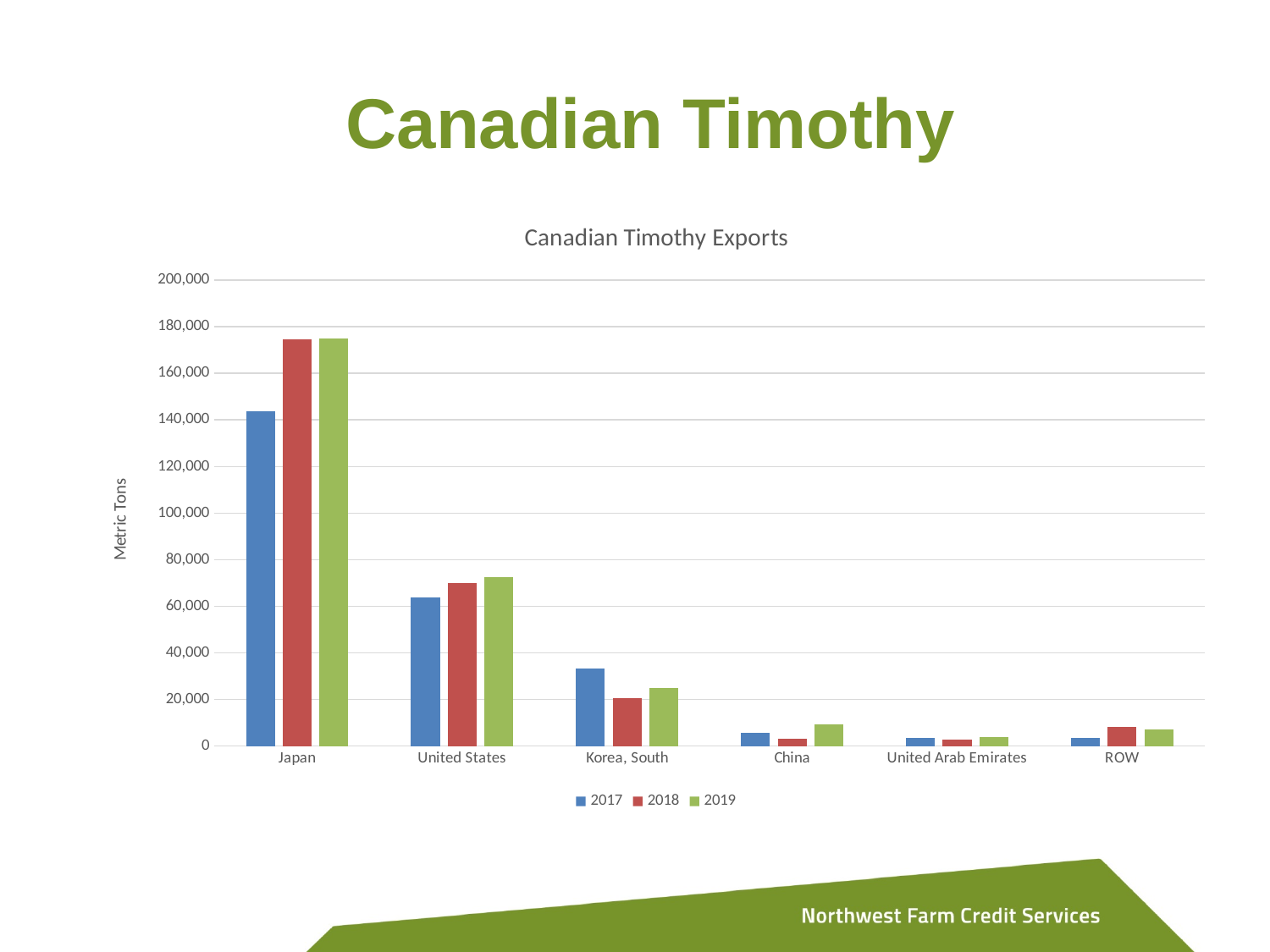
How many export destination categories are shown on the x axis? 6 Is the value for Korea, South in 2017 greater or less than 20,000? greater Is the value for United States in 2019 greater or less than 80,000? less How many series does the legend list? 3 Which is larger for Korea, South: the 2017 value or the 2018 value? 2017 What type of chart is shown on the slide? Bar chart Which is larger for China: the 2018 value or the 2019 value? 2019 What is the title of the chart? Canadian Timothy Exports Is the value for Japan in 2017 greater or less than 140,000? greater What unit is shown on the y axis label? Metric Tons Which destination has the highest Canadian timothy exports in 2019? Japan